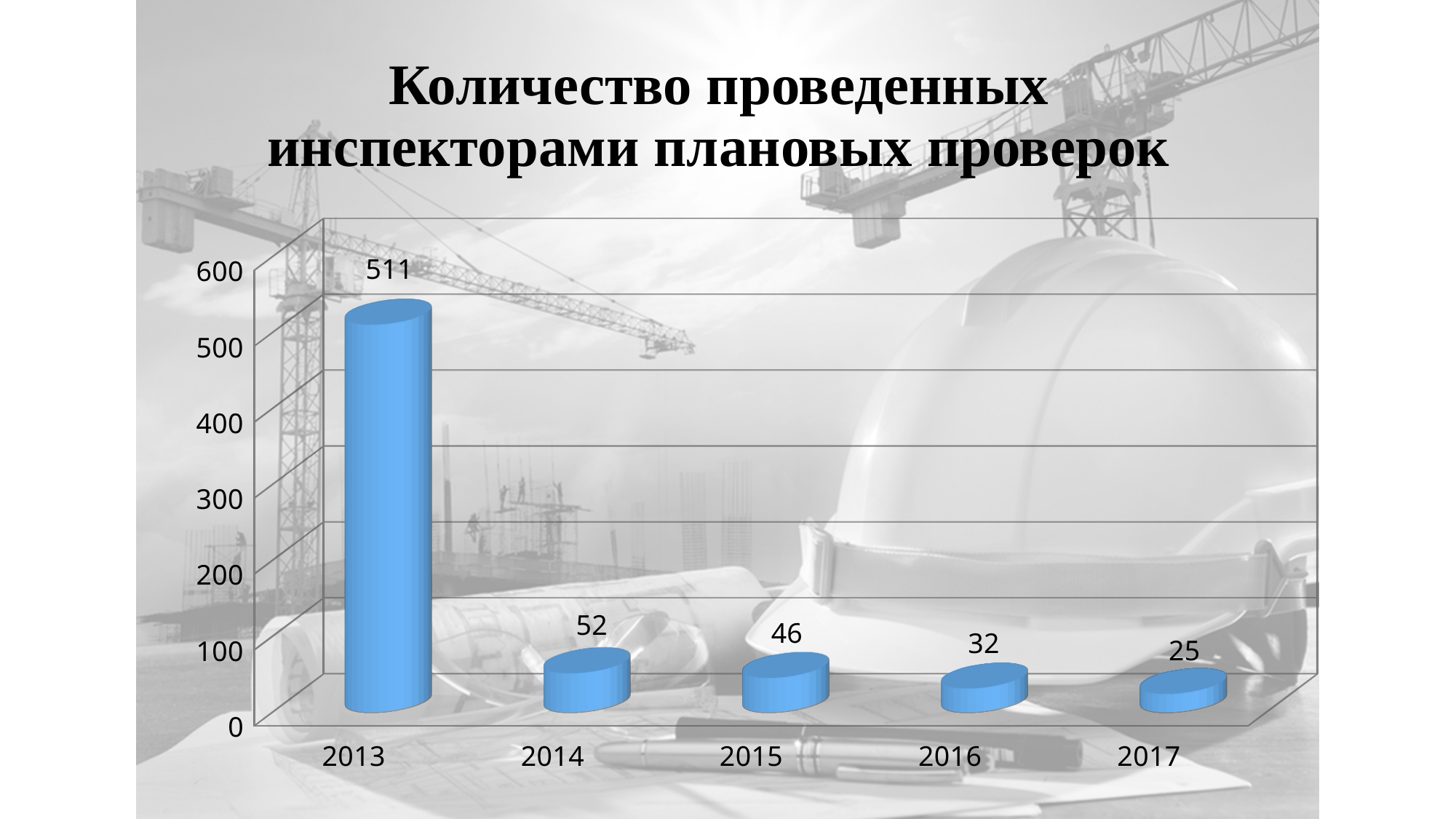
What is the value for 2015? 46 What is the difference between the values for 2016 and 2017? 7 Which year has the highest value? 2013 Which is larger, the value for 2014 or the value for 2016? 2014 What is the value for 2013? 511 What is the difference between the values for 2013 and 2014? 459 How many years are shown on the x axis? 5 What is the value for 2017? 25 What kind of chart is shown on the slide? bar chart Is the value for 2013 greater or less than 500? greater Which year has the lowest value? 2017 Do the values rise or fall from 2013 to 2017? fall